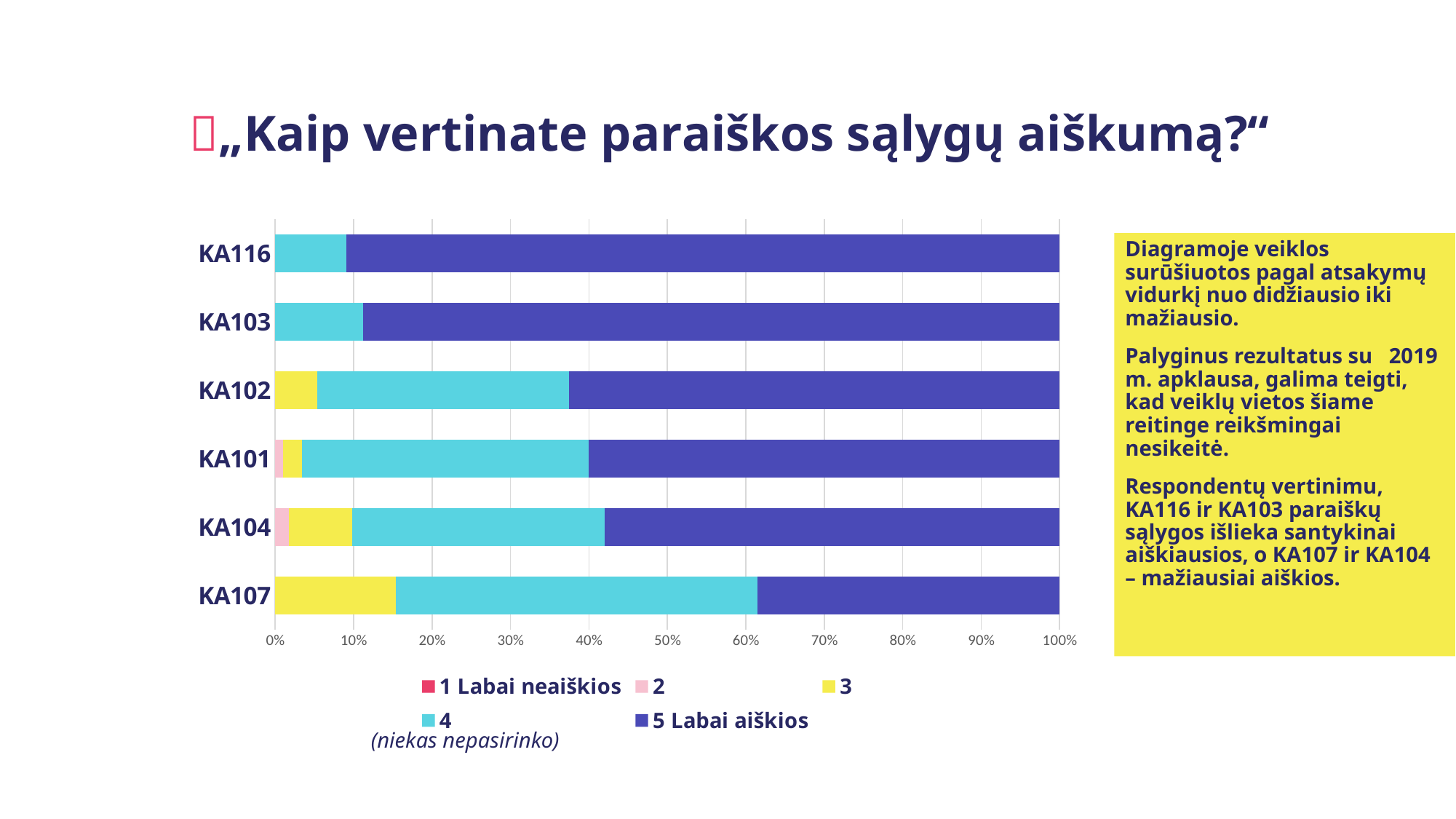
How many categories (KA codes) are plotted on the chart? 6 Is the "5 Labai aiškios" share for KA104 greater or less than 50%? greater How many series does the legend list? 5 Is the "5 Labai aiškios" share for KA116 greater or less than 80%? greater Is the "3" share for KA107 greater or less than 10%? greater Which category has the largest share of the "3" rating? KA107 What kind of chart is shown on the slide? Stacked bar chart Which has a larger "5 Labai aiškios" share, KA116 or KA107? KA116 Which has a larger "4" share, KA102 or KA116? KA102 Which category has the smallest share of the "5 Labai aiškios" rating? KA107